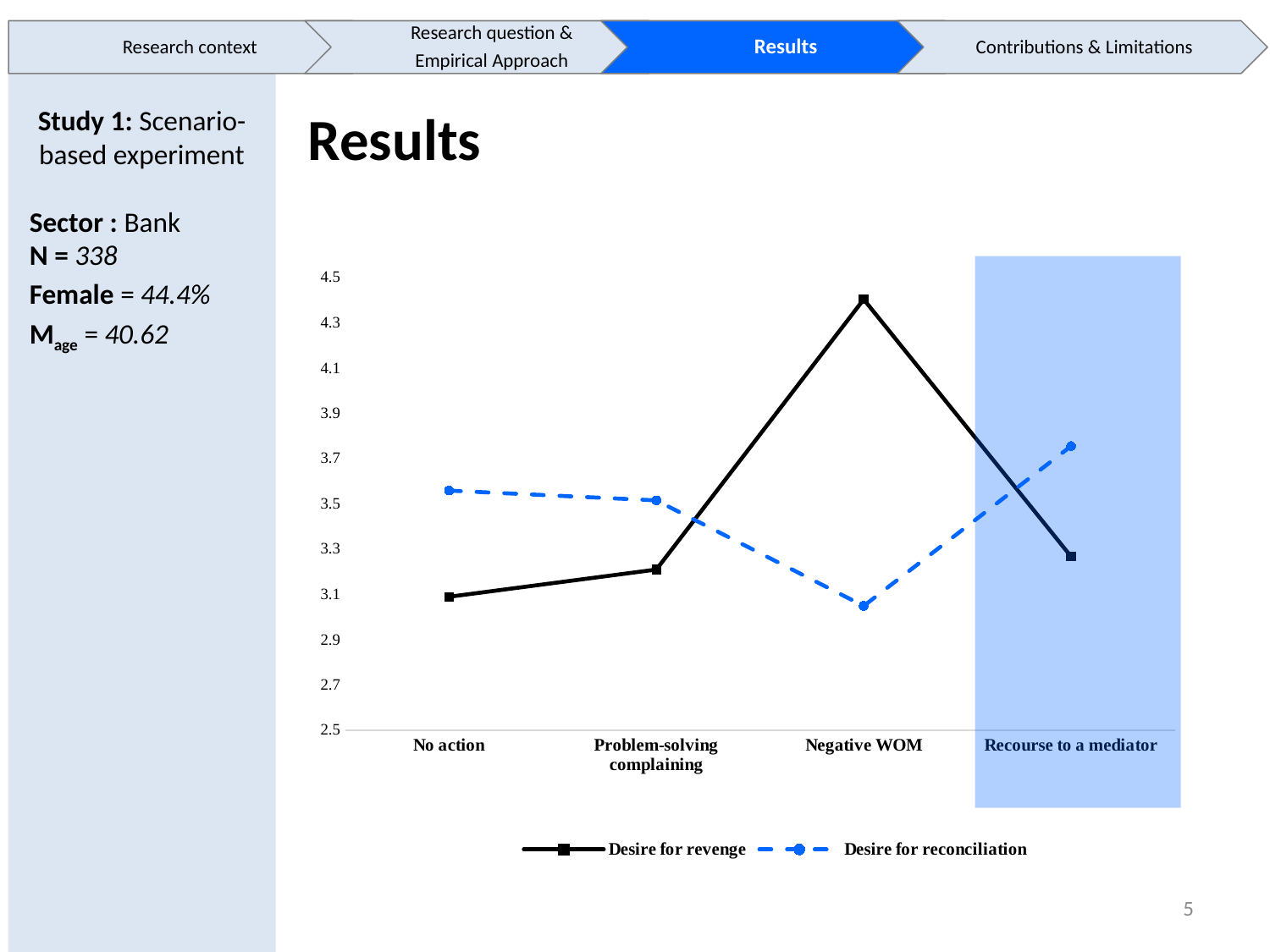
For which category is Desire for revenge lowest? No action Which category on the x axis is highlighted with a blue shaded box? Recourse to a mediator Is the value for Desire for revenge at Negative WOM greater or less than 4.1? greater Is the value for Desire for reconciliation at Recourse to a mediator greater or less than 3.5? greater For which category is Desire for reconciliation highest? Recourse to a mediator For which category is Desire for reconciliation lowest? Negative WOM How many categories are shown on the x axis of the chart? 4 For which category is Desire for revenge highest? Negative WOM How many series does the chart legend list? 2 Is the value for Desire for reconciliation at Negative WOM greater or less than 3.3? less At Negative WOM, which series has the larger value: Desire for revenge or Desire for reconciliation? Desire for revenge What kind of chart is shown on the slide? Line chart